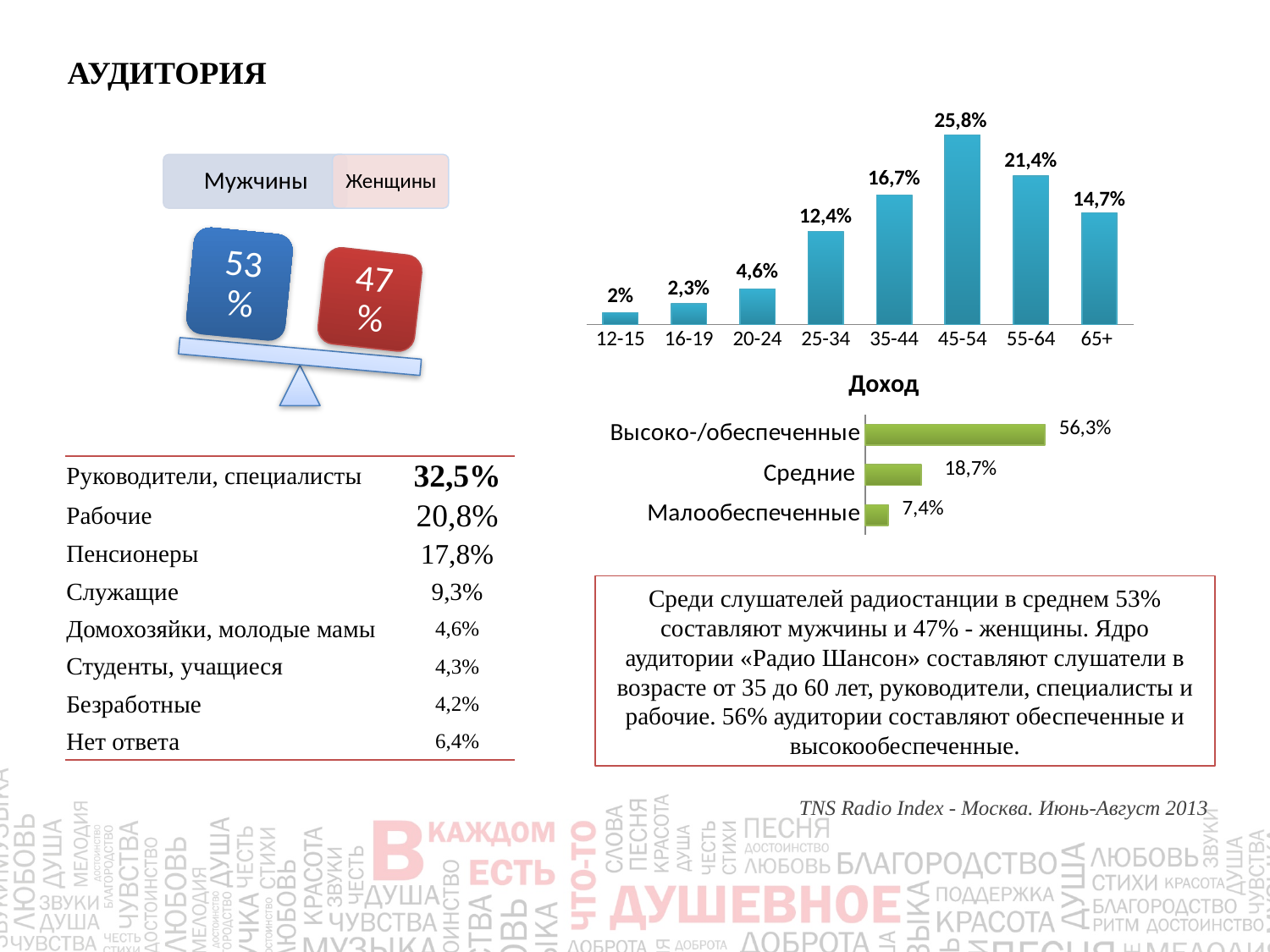
In the chart titled Доход, which category has the highest value? Высоко-/обеспеченные In the age-group bar chart at the top right, what is the value for the 45-54 group? 25,8% In the age-group bar chart at the top right, do the values rise or fall from 12-15 to 45-54? rise In the chart titled Доход, what is the difference between the values for Высоко-/обеспеченные and Малообеспеченные? 48,9% In the age-group bar chart at the top right, which is larger: the value for 35-44 or the value for 55-64? 55-64 In the age-group bar chart at the top right, what is the difference between the values for 55-64 and 65+? 6,7% In the age-group bar chart at the top right, which age group has the lowest value? 12-15 In the chart titled Доход, what is the value for Средние? 18,7% How many age groups are shown in the age-group bar chart at the top right? 8 In the age-group bar chart at the top right, which age group has the highest value? 45-54 In the age-group bar chart at the top right, what is the value for the 25-34 group? 12,4% What kind of chart is the chart titled Доход? bar chart